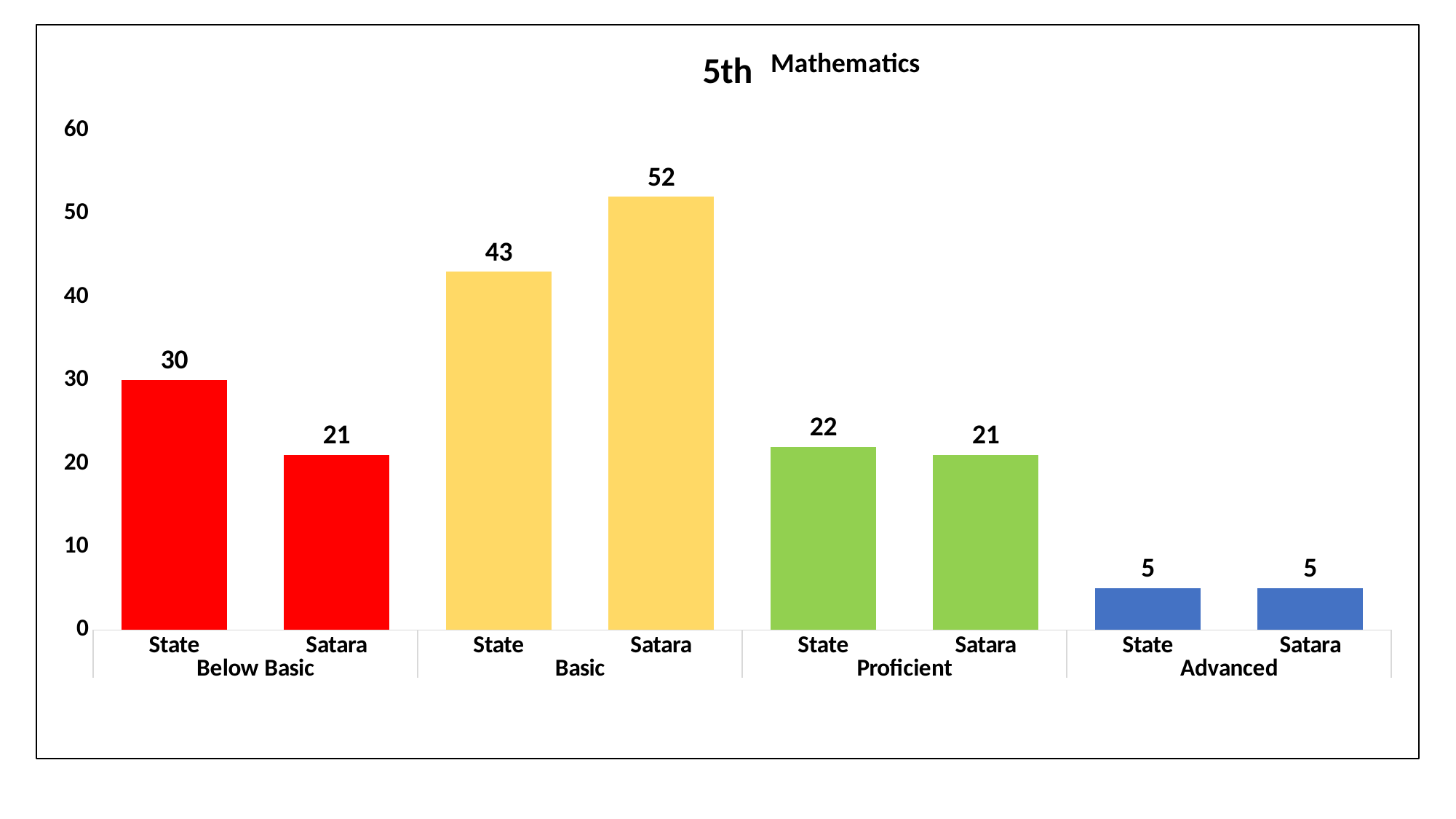
Is the value for State in the Basic category greater or less than 40? greater What is the value for State in the Below Basic category? 30 What is the difference between the State and Satara values in the Below Basic category? 9 How many bars are plotted on the chart? 8 What is the value for State in the Proficient category? 22 How many performance level groups are shown on the x axis? 4 What is the title of the chart? 5th Mathematics Which bar has the highest value on the chart? Satara, Basic Which is larger: State in Below Basic or Satara in Below Basic? State What kind of chart is shown on the slide? Bar chart What is the value for Satara in the Basic category? 52 What is the difference between the Satara and State values in the Basic category? 9